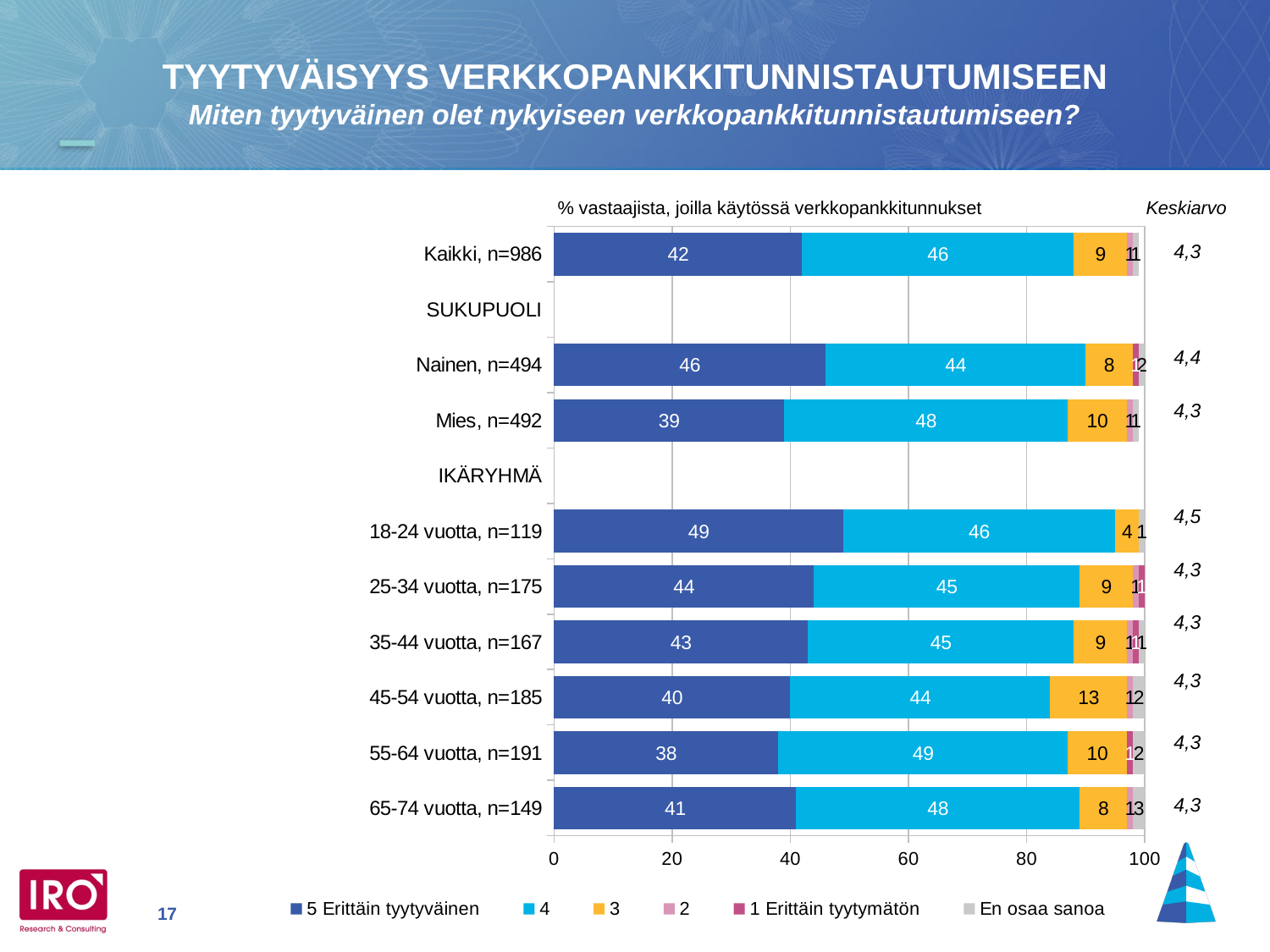
How many groups have bars plotted in the chart? 9 Which has a larger '3' segment: Mies, n=492 or 45-54 vuotta, n=185? 45-54 vuotta, n=185 What is the Keskiarvo (mean) shown for 18-24 vuotta, n=119? 4,5 Which group has the highest share of 5 Erittäin tyytyväinen? 18-24 vuotta, n=119 What is the value of the '4' segment for Mies, n=492? 48 How many series does the legend list? 6 How much larger is the 5 Erittäin tyytyväinen share for Nainen, n=494 than for Mies, n=492? 7 What is the value of the '3' segment for 45-54 vuotta, n=185? 13 Which group has the highest Keskiarvo value? 18-24 vuotta, n=119 What kind of chart is shown on the slide? Stacked bar chart Which group has the lowest share of 5 Erittäin tyytyväinen? 55-64 vuotta, n=191 What percentage of all respondents (Kaikki, n=986) answered 5 Erittäin tyytyväinen? 42